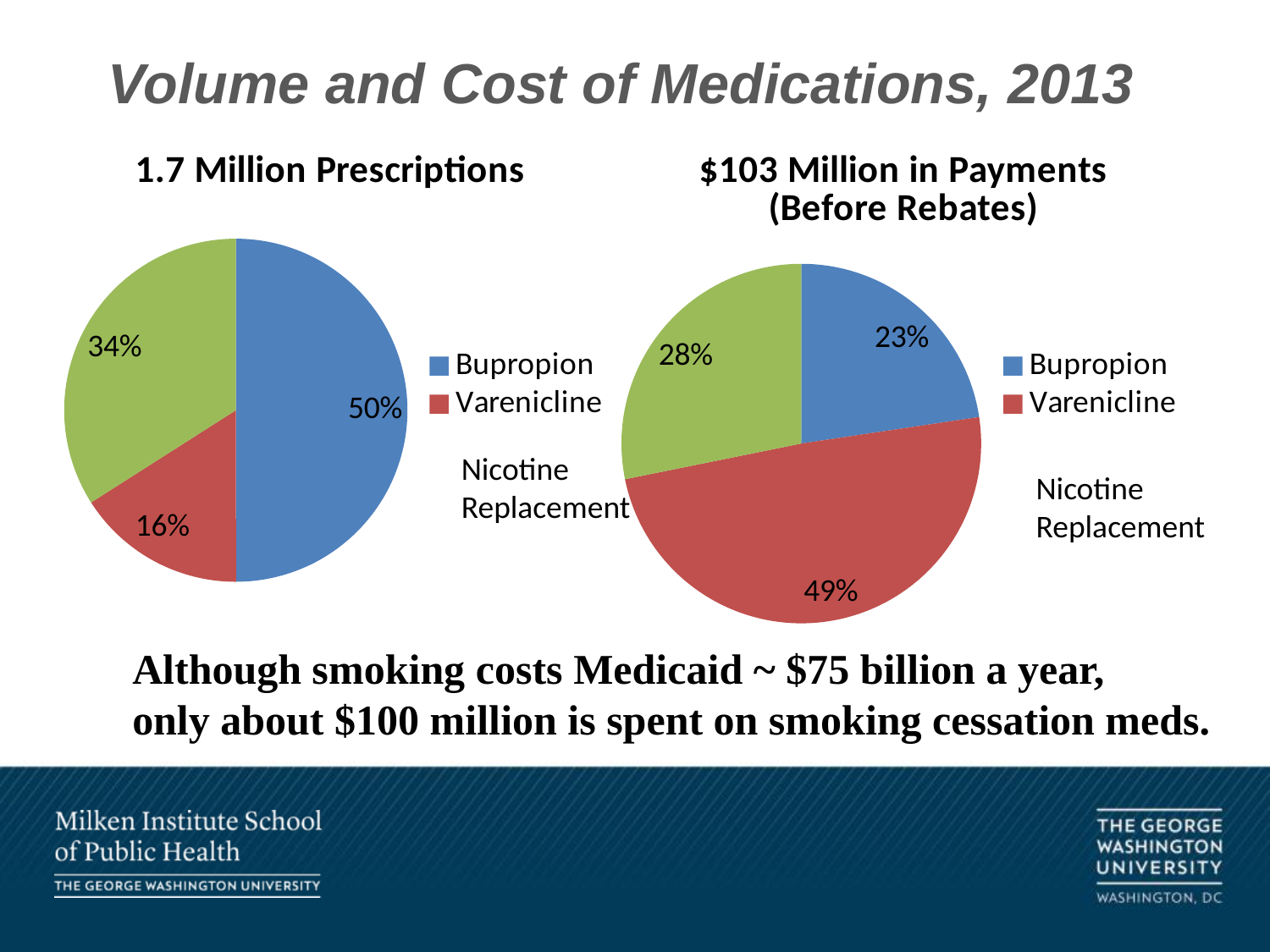
In the '$103 Million in Payments (Before Rebates)' chart, which medication has the smallest share? Bupropion In the '1.7 Million Prescriptions' chart, what share of prescriptions is Varenicline? 16% In the '$103 Million in Payments (Before Rebates)' chart, what share of payments is Nicotine Replacement? 28% What type of chart is used for the '1.7 Million Prescriptions' data? Pie chart In the '$103 Million in Payments (Before Rebates)' chart, which is larger, the Varenicline share or the Nicotine Replacement share? Varenicline In the '$103 Million in Payments (Before Rebates)' chart, what share of payments is Varenicline? 49% How many medication categories are shown in the '$103 Million in Payments (Before Rebates)' chart? 3 In the '1.7 Million Prescriptions' chart, what is the difference in percentage points between the Bupropion and Varenicline shares? 34 percentage points In the '1.7 Million Prescriptions' chart, what share of prescriptions is Bupropion? 50% In the '1.7 Million Prescriptions' chart, what share of prescriptions is Nicotine Replacement? 34% In the '$103 Million in Payments (Before Rebates)' chart, what share of payments is Bupropion? 23% In the '1.7 Million Prescriptions' chart, which medication has the largest share? Bupropion